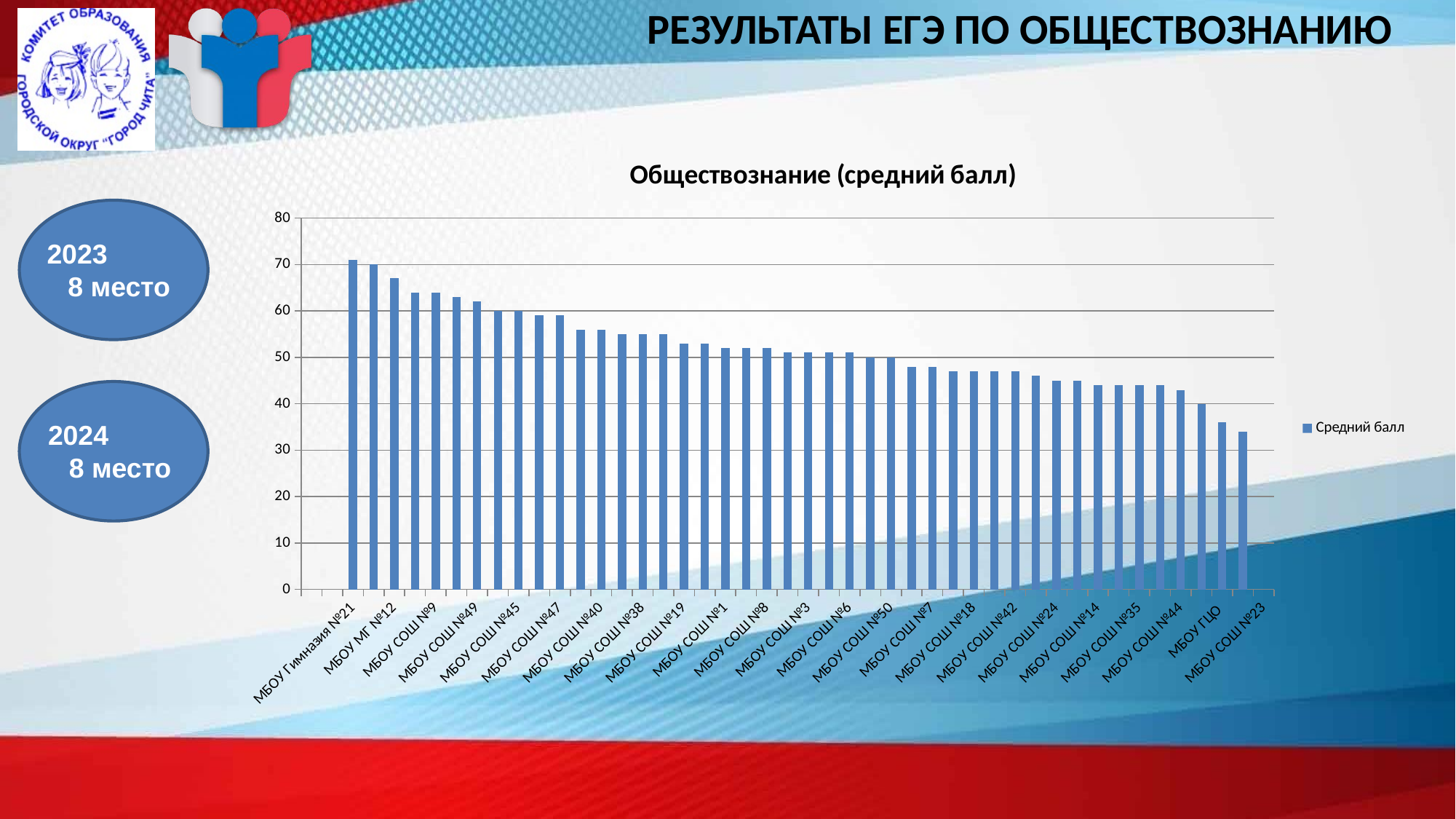
Is the value for МБОУ СОШ №9 greater or less than 60? greater Is the value for МБОУ Гимназия №21 greater or less than 70? greater What is the legend entry of the chart? Средний балл Which has the larger value, МБОУ СОШ №40 or МБОУ ГЦО? МБОУ СОШ №40 Which school has the highest average score in the chart? МБОУ Гимназия №21 What is the title of the chart? Обществознание (средний балл) Do the values rise or fall from left to right along the x axis? fall How many series does the legend list? 1 What kind of chart is shown on the slide? bar chart Is the value for МБОУ СОШ №24 greater or less than 50? less